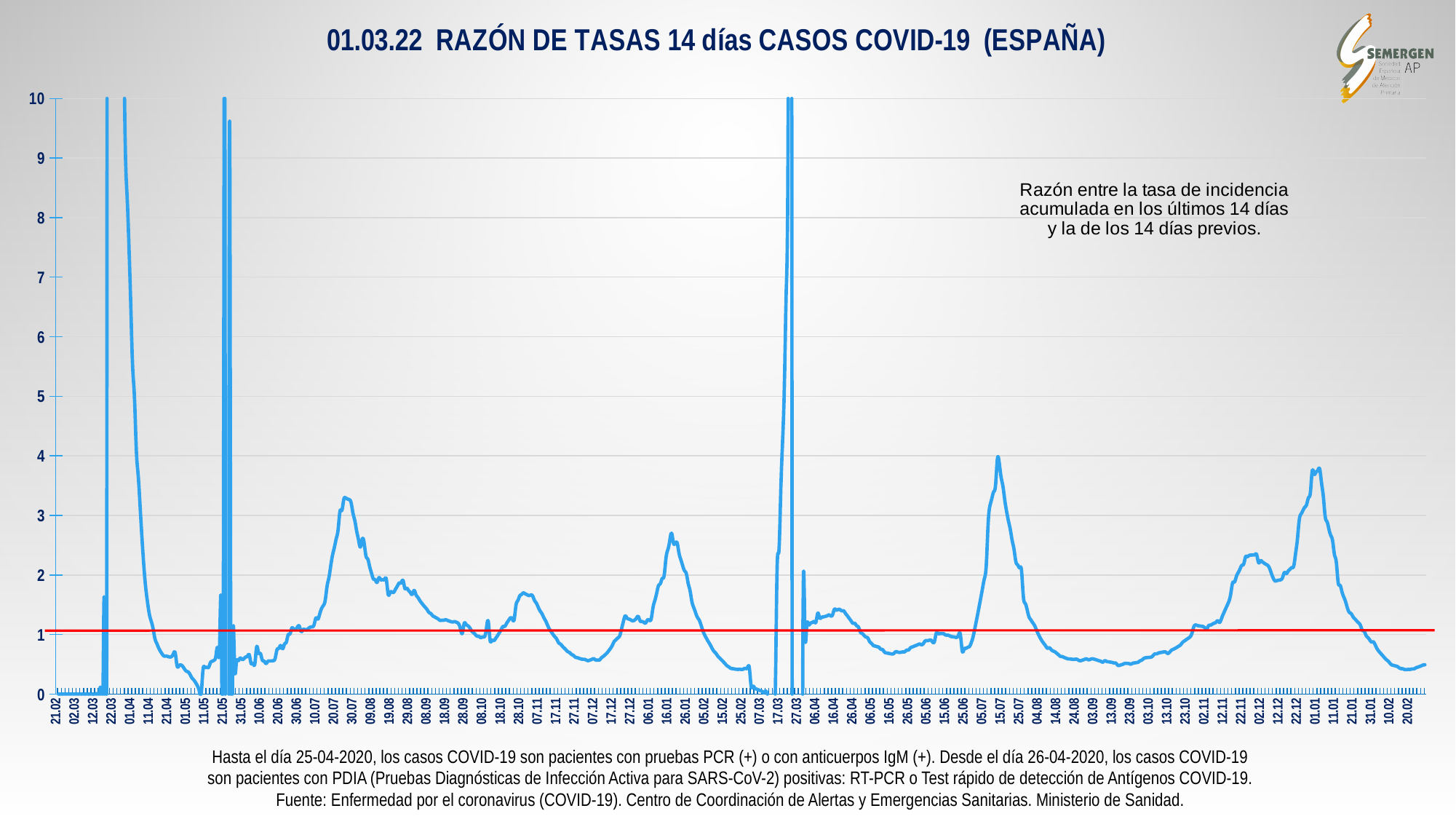
Is the value at 15.07 (the peak in July) greater or less than 3? greater Is the value at 20.02 greater or less than 1? less Is the value at 01.01 greater or less than 3? greater What is the highest value shown on the vertical axis? 10 What is the title of the chart? 01.03.22 RAZÓN DE TASAS 14 días CASOS COVID-19 (ESPAÑA) What kind of chart is shown on the slide? line chart Does the line rise or fall between 15.07 and 04.08? fall Which is larger, the value at 15.07 or the value at 24.08? 15.07 Does the line rise or fall between 01.01 and 20.02? fall